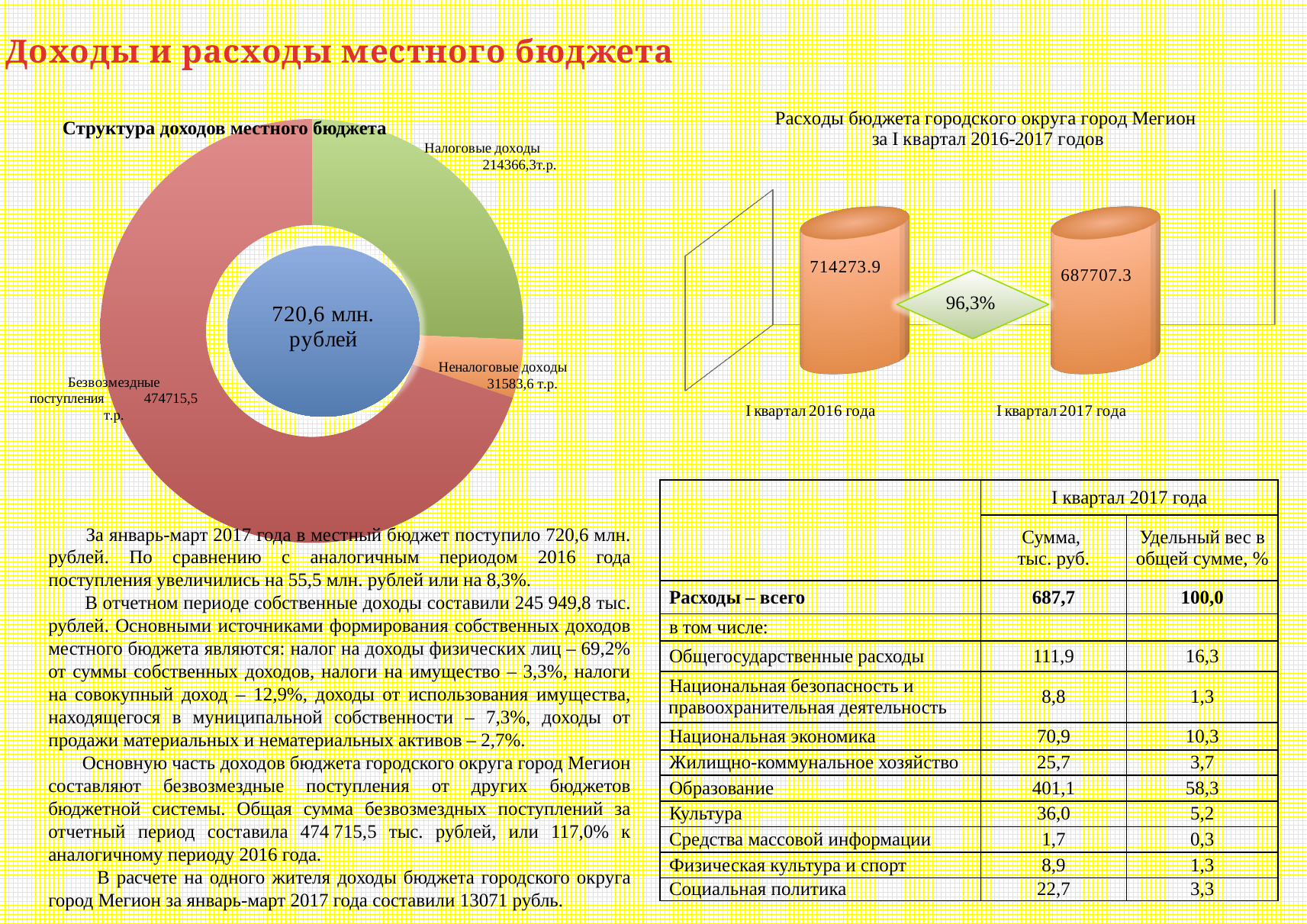
On the chart 'Расходы бюджета городского округа город Мегион за I квартал 2016-2017 годов', which period has the larger value, I квартал 2016 года or I квартал 2017 года? I квартал 2016 года On the doughnut chart 'Структура доходов местного бюджета', what is the value for Безвозмездные поступления? 474715,5 т.р. On the doughnut chart 'Структура доходов местного бюджета', how many categories are shown? 3 On the doughnut chart 'Структура доходов местного бюджета', what total is written in the centre of the chart? 720,6 млн. рублей On the doughnut chart 'Структура доходов местного бюджета', which category has the smallest value? Неналоговые доходы On the chart 'Расходы бюджета городского округа город Мегион за I квартал 2016-2017 годов', what is the difference between the 2016 and 2017 values? 26566.6 On the chart 'Расходы бюджета городского округа город Мегион за I квартал 2016-2017 годов', what is the value for I квартал 2017 года? 687707.3 On the doughnut chart 'Структура доходов местного бюджета', what is the value for Неналоговые доходы? 31583,6 т.р. On the doughnut chart 'Структура доходов местного бюджета', which category has the largest value? Безвозмездные поступления On the doughnut chart 'Структура доходов местного бюджета', what is the difference between Безвозмездные поступления and Налоговые доходы? 260349,2 т.р. On the chart 'Расходы бюджета городского округа город Мегион за I квартал 2016-2017 годов', what is the value for I квартал 2016 года? 714273.9 On the doughnut chart 'Структура доходов местного бюджета', what is the value for Налоговые доходы? 214366,3 т.р.